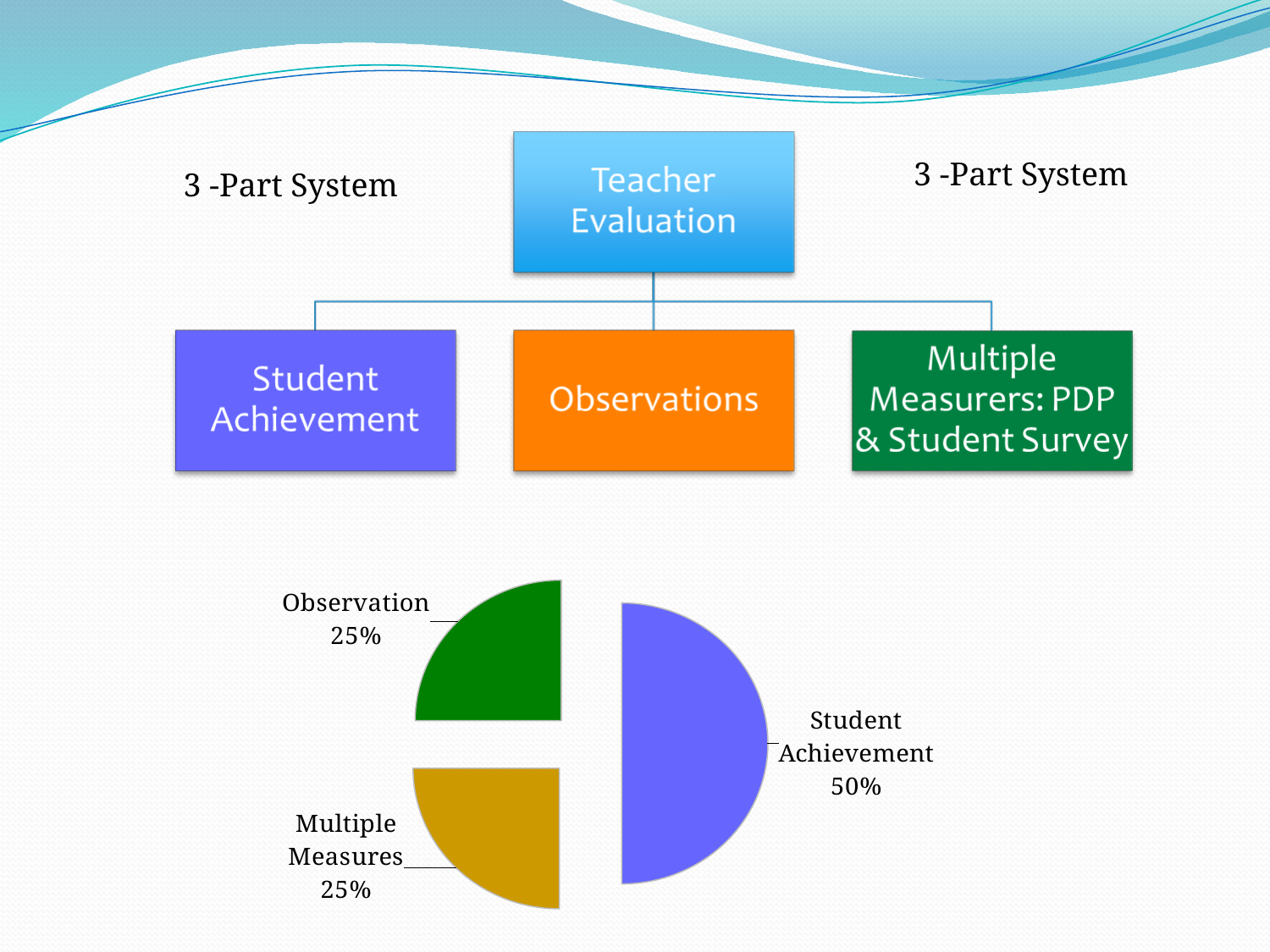
Which is larger in the pie chart, Student Achievement or Multiple Measures? Student Achievement What kind of chart is shown at the bottom of the slide? pie chart What share of the pie chart does Observation represent? 25% What share of the pie chart does Multiple Measures represent? 25% What share of the pie chart does Student Achievement represent? 50% What is the difference between the Student Achievement share and the Observation share in the pie chart? 25% What colour is the Student Achievement slice in the pie chart? blue/purple How many slices does the pie chart have? 3 What colour is the Observation slice in the pie chart? green What is the combined share of Observation and Multiple Measures in the pie chart? 50% Which slice of the pie chart is the largest? Student Achievement